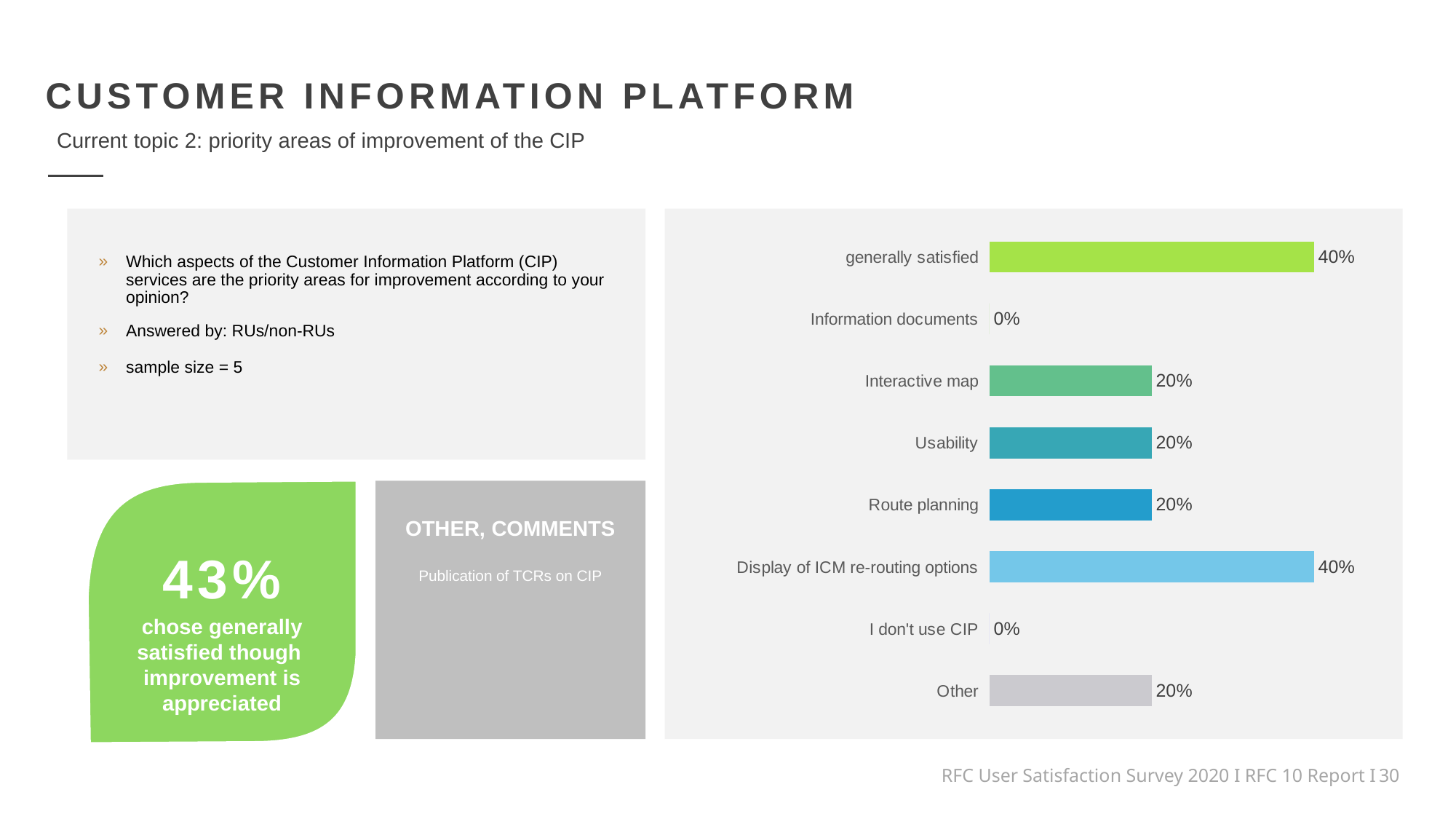
Which is larger, the value for 'Route planning' or the value for 'Display of ICM re-routing options'? Display of ICM re-routing options What is the difference between the values for 'generally satisfied' and 'Usability'? 20% How many categories are shown in the chart? 8 Which categories have the lowest value in the chart? Information documents and I don't use CIP What is the sample size stated on the slide for this chart? 5 What is the value for 'generally satisfied'? 40% How many categories in the chart have a value of 20%? 4 What is the value for 'Interactive map'? 20% What is the value for 'Other'? 20% What is the value for 'Display of ICM re-routing options'? 40% What kind of chart is shown on the slide? Bar chart What is the value for 'Information documents'? 0%